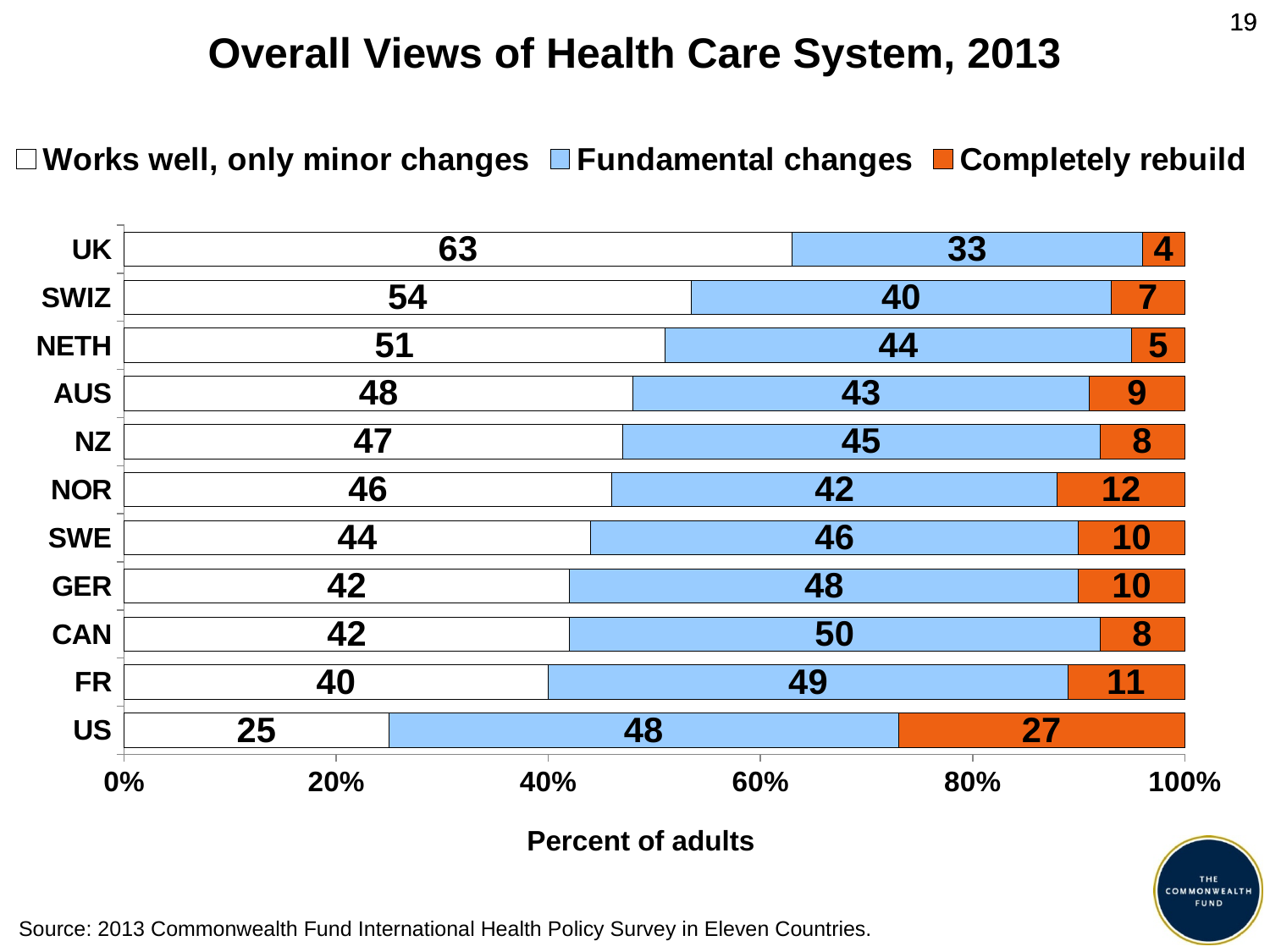
What is the 'Completely rebuild' value for the US? 27 Which country has the lowest 'Works well, only minor changes' value? US Which country has the highest 'Works well, only minor changes' value? UK What kind of chart is shown on the slide? Stacked bar chart What is the difference between the 'Works well, only minor changes' values for the UK and the US? 38 What percentage of adults in the UK say the health care system works well, only minor changes? 63 Which is larger: the 'Fundamental changes' value for GER or for NOR? GER What is the x-axis label of the chart? Percent of adults How many countries are shown in the chart? 11 Which country has the highest 'Completely rebuild' value? US How many series does the legend list? 3 What is the 'Fundamental changes' value for CAN? 50